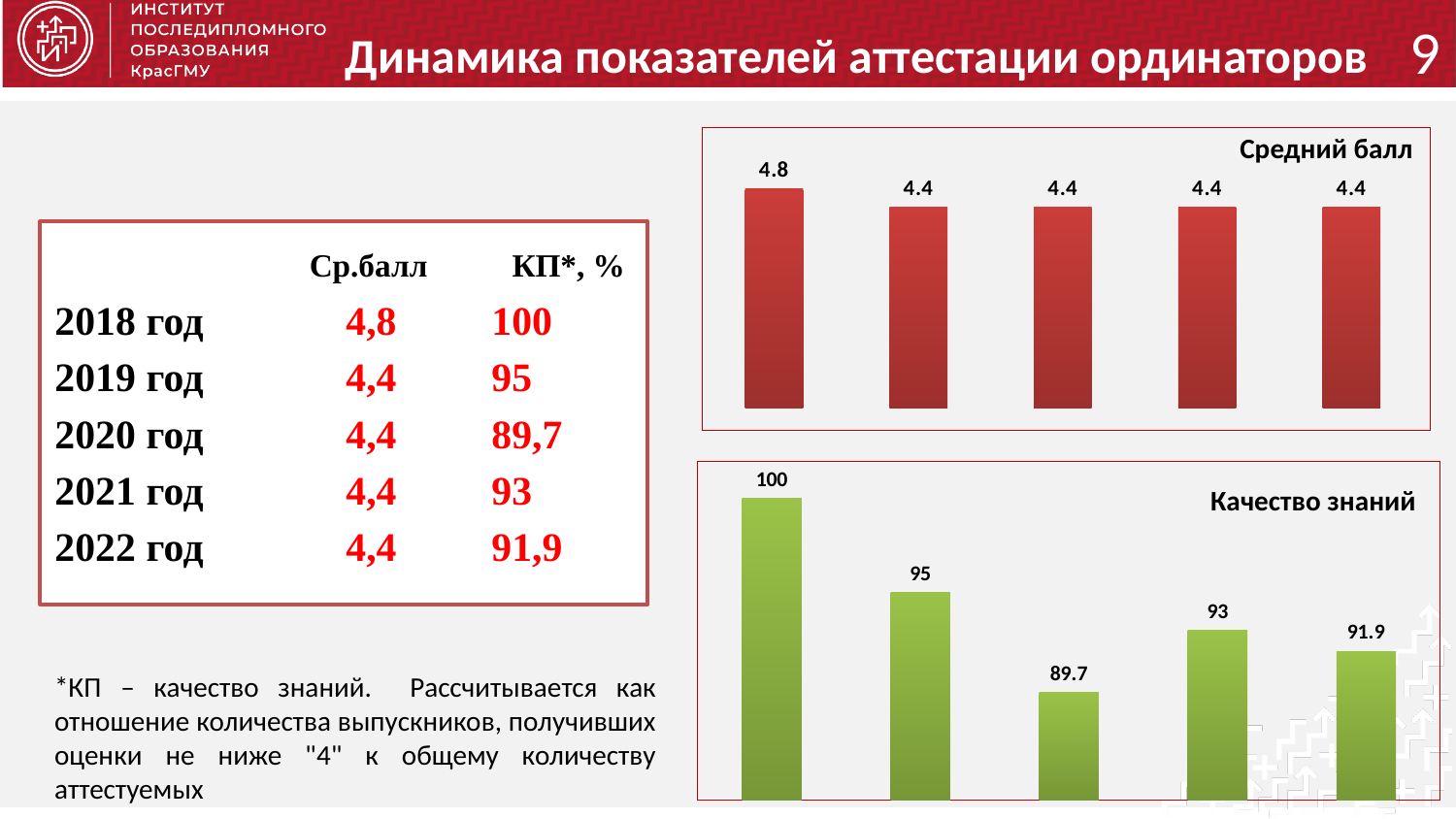
What type of chart is the 'Качество знаний' chart? bar chart In the 'Средний балл' chart, what is the value of the last bar? 4.4 In the 'Средний балл' chart, what is the value of the first bar? 4.8 In the 'Качество знаний' chart, which bar has the lowest value? the third bar (89.7) What colour are the bars in the 'Средний балл' chart? red In the 'Качество знаний' chart, which is larger: the fourth bar or the fifth bar? the fourth bar (93) In the 'Средний балл' chart, how many bars are plotted? 5 In the 'Качество знаний' chart, what is the value of the first bar? 100 In the 'Качество знаний' chart, what is the value of the third bar? 89.7 In the 'Средний балл' chart, what is the difference between the first bar and the second bar? 0.4 In the 'Качество знаний' chart, what is the value of the last bar? 91.9 In the 'Качество знаний' chart, what is the difference between the first bar and the second bar? 5